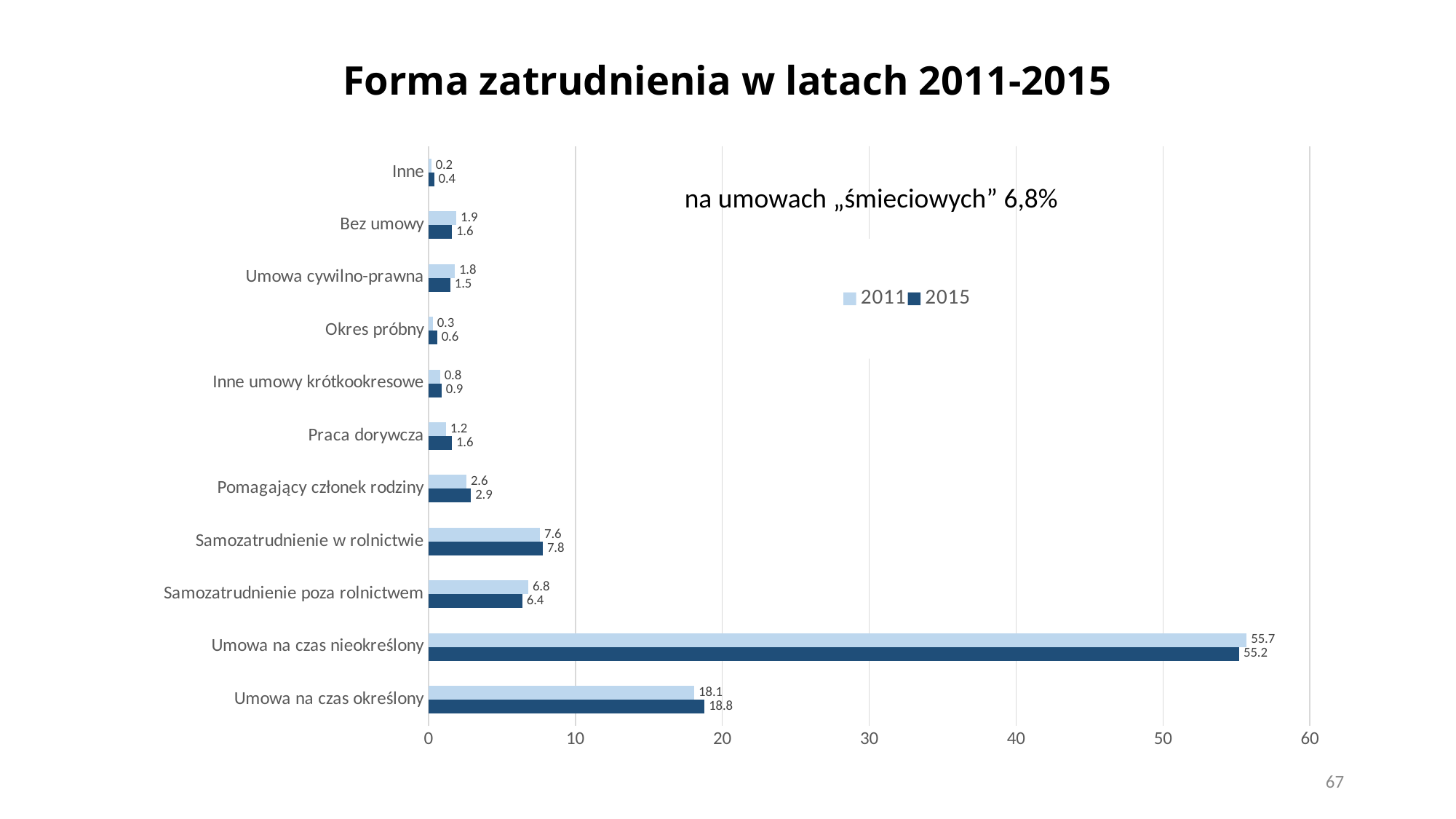
What is the 2011 value for Samozatrudnienie w rolnictwie? 7.6 What is the 2011 value for Bez umowy? 1.9 What is the title of the chart? Forma zatrudnienia w latach 2011-2015 How many series does the legend list? 2 What kind of chart is shown on the slide? bar chart Which category has the lowest 2011 value? Inne What is the 2015 value for Umowa na czas określony? 18.8 What is the difference between the 2011 and 2015 values for Umowa na czas nieokreślony? 0.5 Which is larger for Samozatrudnienie poza rolnictwem, the 2011 value or the 2015 value? 2011 Is the 2011 value for Umowa na czas określony greater or less than 20? less How many categories are shown on the chart? 11 Which category has the highest 2015 value? Umowa na czas nieokreślony